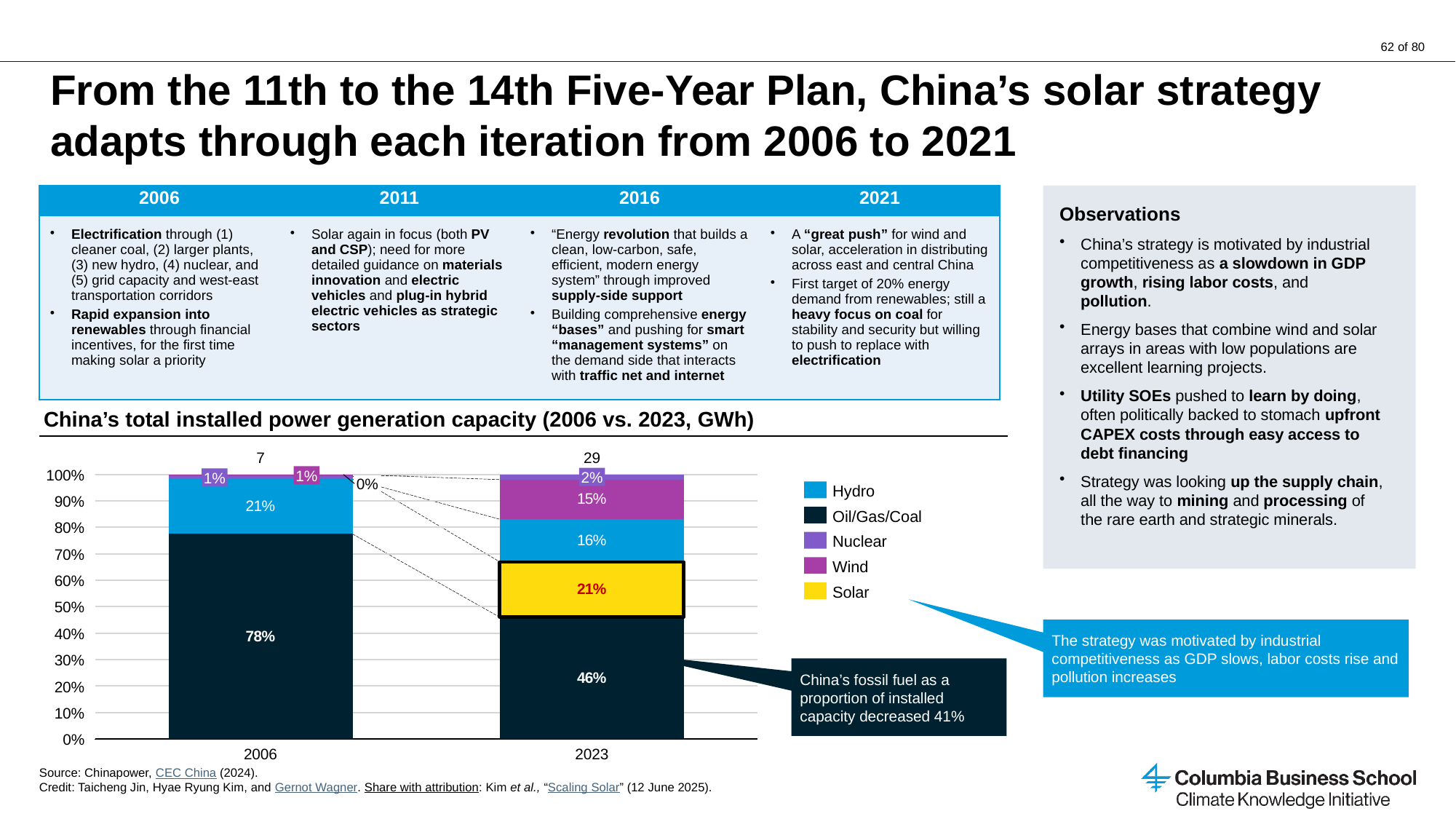
What kind of chart is shown under the title "China's total installed power generation capacity (2006 vs. 2023, GWh)"? Stacked bar chart Which source had the largest share of installed capacity in 2023? Oil/Gas/Coal What total value is printed above the 2023 bar? 29 What share of China's installed capacity was Wind in 2023? 15% What share of China's installed capacity was Hydro in 2006? 21% What share of China's installed capacity was Solar in 2023? 21% Which source had the smallest share of installed capacity in 2023? Nuclear What share of China's installed capacity was Oil/Gas/Coal in 2023? 46% In 2023, which had a larger share of installed capacity, Hydro or Wind? Hydro By how many percentage points did the Oil/Gas/Coal share fall from 2006 to 2023? 32 What share of China's installed capacity was Oil/Gas/Coal in 2006? 78% How many series does the chart legend list? 5